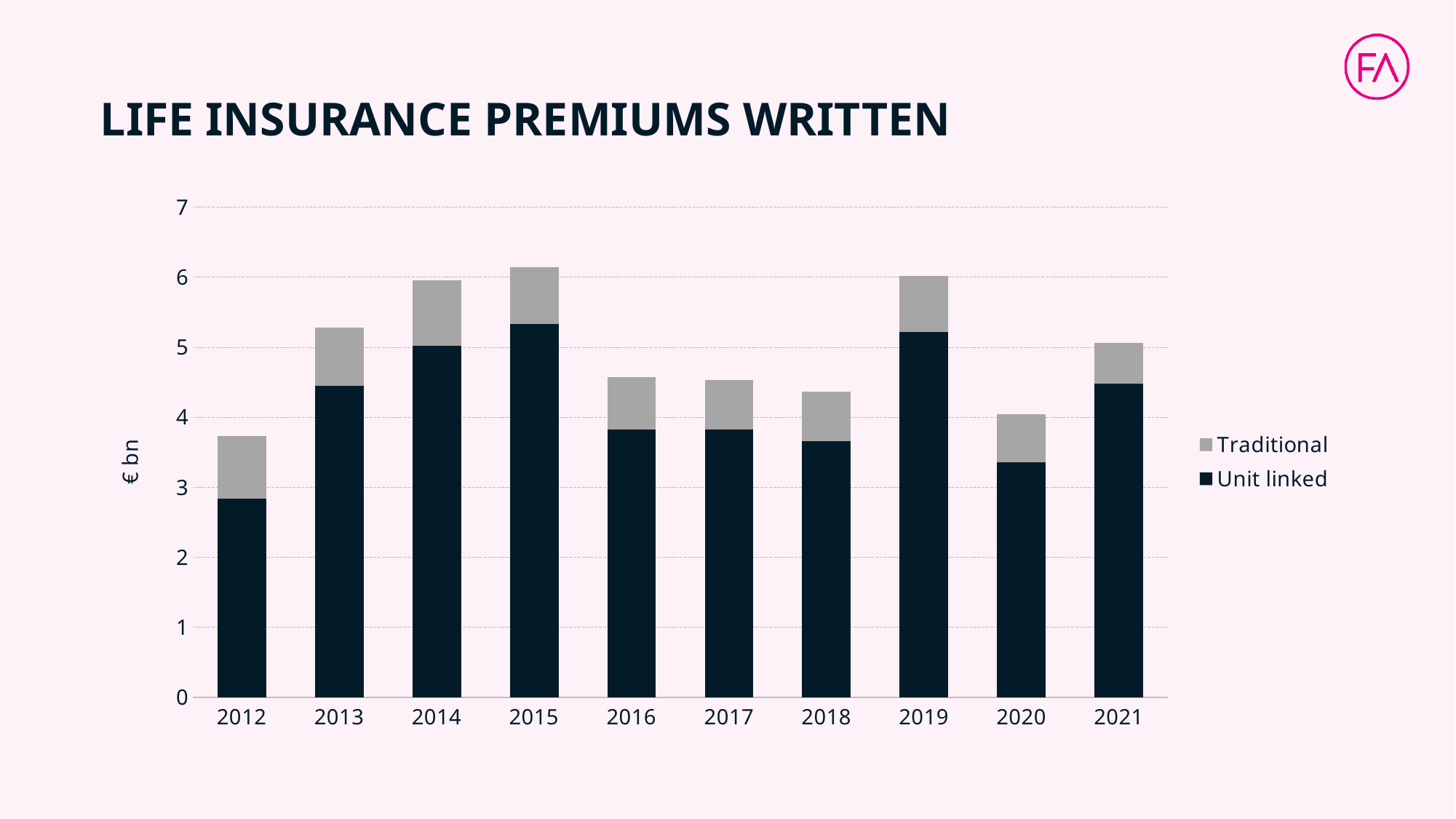
Which year has the highest total life insurance premiums written? 2015 Is the Unit linked value for 2013 greater or less than 4? greater Is the Unit linked value for 2020 greater or less than 4? less Which year has the larger total premiums written, 2013 or 2020? 2013 How many series does the legend list? 2 What unit is shown on the y axis of the chart? € bn How many years are shown on the x axis of the chart? 10 Is the total value for 2015 greater or less than 6? greater Which year has the lowest total life insurance premiums written? 2012 Do the total premiums written rise or fall from 2016 to 2018? fall What kind of chart is shown on the slide? Stacked bar chart